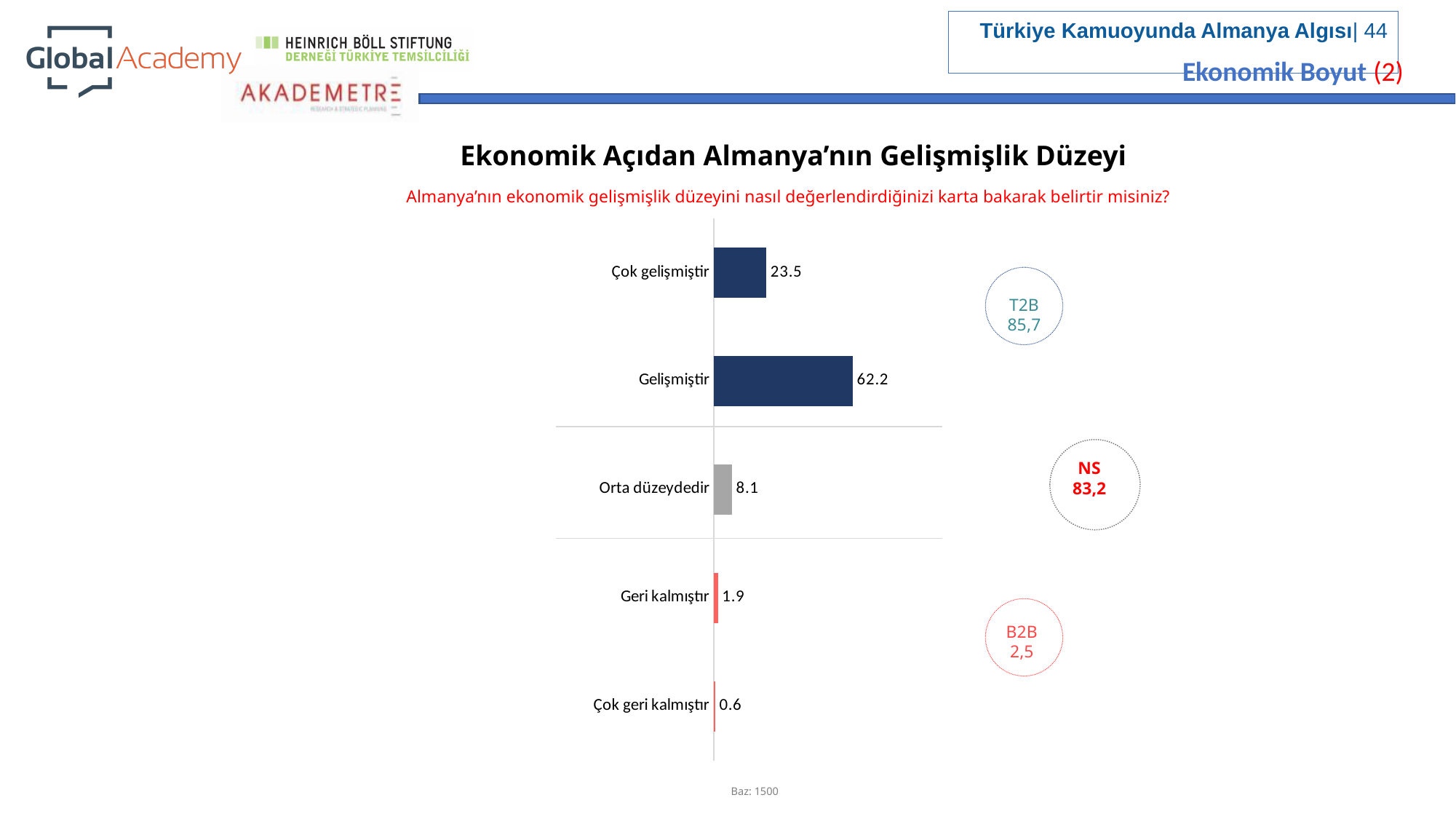
What is the combined value of Çok gelişmiştir and Gelişmiştir? 85.7 Which category has the highest value? Gelişmiştir What is the value for Çok geri kalmıştır? 0.6 What is the value for Gelişmiştir? 62.2 What is the value for Orta düzeydedir? 8.1 What is the difference between the values for Gelişmiştir and Çok gelişmiştir? 38.7 What is the value for Çok gelişmiştir? 23.5 How many categories are shown in the chart? 5 Which is larger, the value for Orta düzeydedir or the value for Geri kalmıştır? Orta düzeydedir What is the title of the chart? Ekonomik Açıdan Almanya'nın Gelişmişlik Düzeyi What kind of chart is shown on the slide? Bar chart Which category has the lowest value? Çok geri kalmıştır